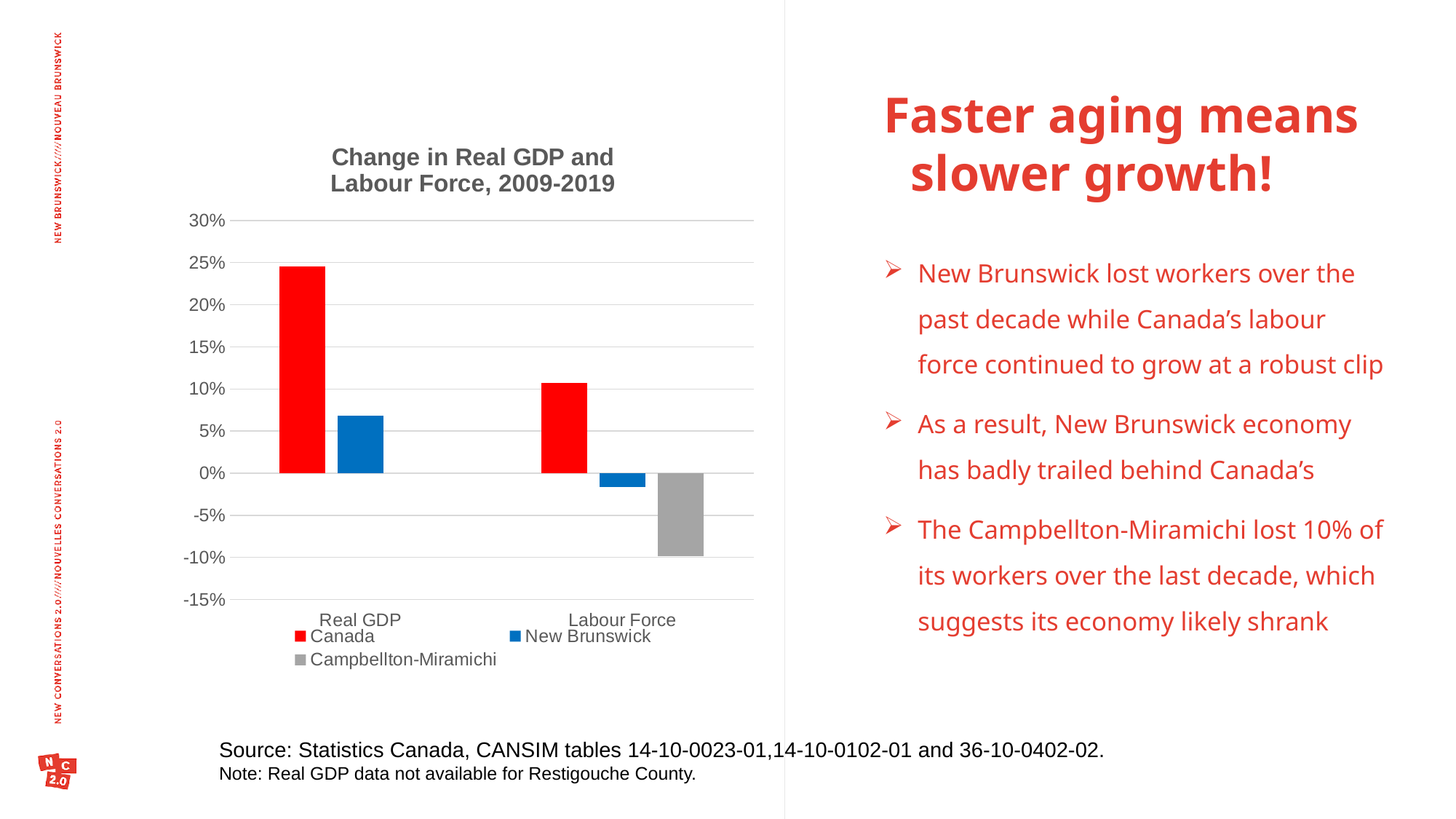
Is the value for Canada's Real GDP greater or less than 20%? greater Which is larger: New Brunswick's Labour Force change or Campbellton-Miramichi's Labour Force change? New Brunswick How many categories are shown on the x axis? 2 Which is larger: Canada's Real GDP change or Canada's Labour Force change? Real GDP Which series has the lowest value for Labour Force? Campbellton-Miramichi Is the value for New Brunswick's Labour Force greater or less than 0%? less Is the value for Canada's Labour Force greater or less than 5%? greater Which series has the highest value for Real GDP? Canada How many series does the legend list? 3 What kind of chart is shown on the slide? bar chart What is the title of the chart? Change in Real GDP and Labour Force, 2009-2019